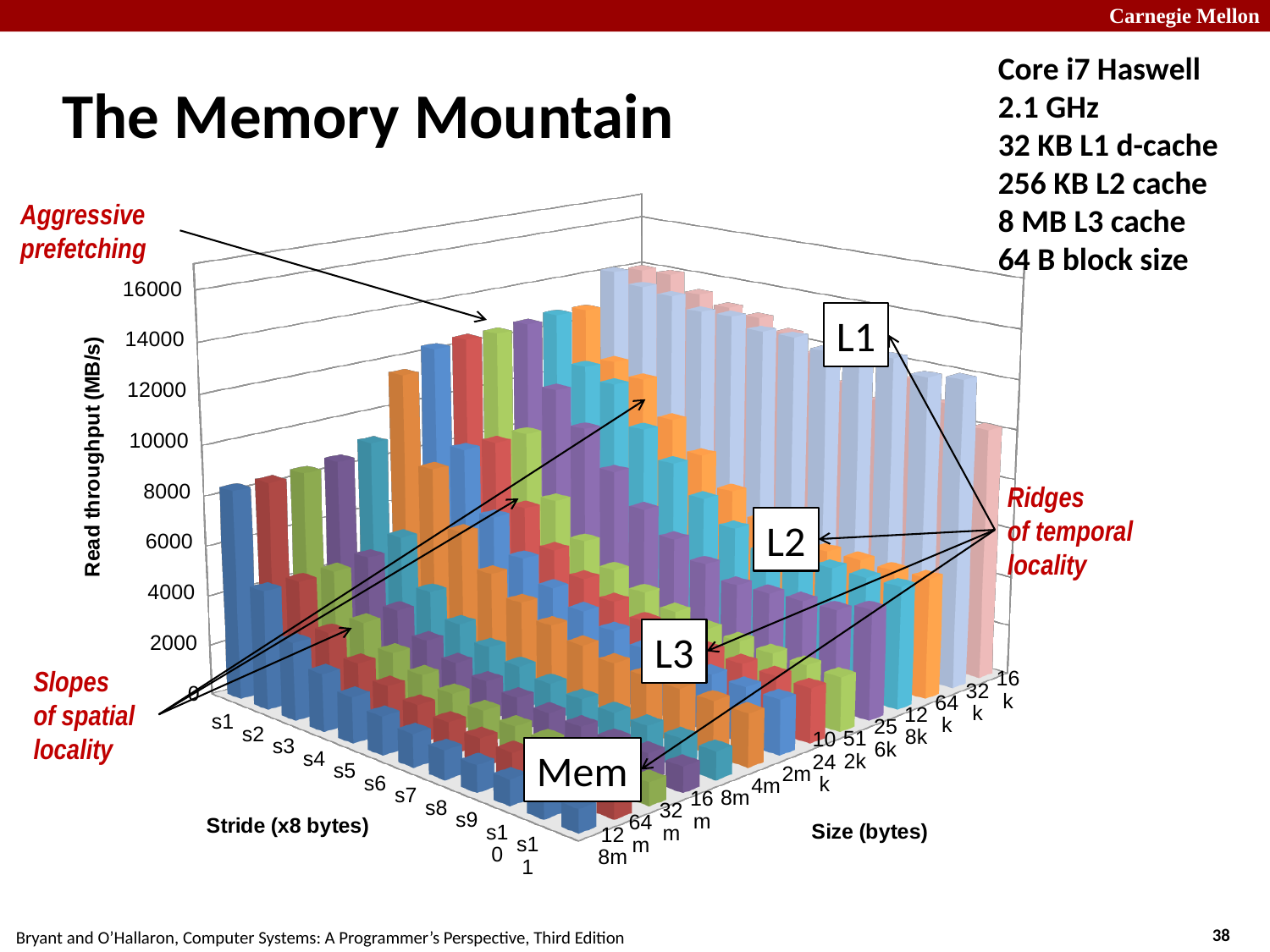
What is the highest tick value shown on the Read throughput (MB/s) axis? 16000 Which stride category has the lowest read throughput for the largest sizes? s11 Is the read throughput for stride s1 at the smallest size greater or less than the read throughput for stride s11 at the largest size? greater What is the label of the vertical axis of the chart? Read throughput (MB/s) For a given stride, does read throughput rise or fall as the size decreases from 128m toward 16k? rise What kind of chart is shown on the slide? bar chart How many stride categories are shown along the Stride (x8 bytes) axis? 11 For a given working-set size, does read throughput rise or fall as the stride increases from s1 to s11? fall